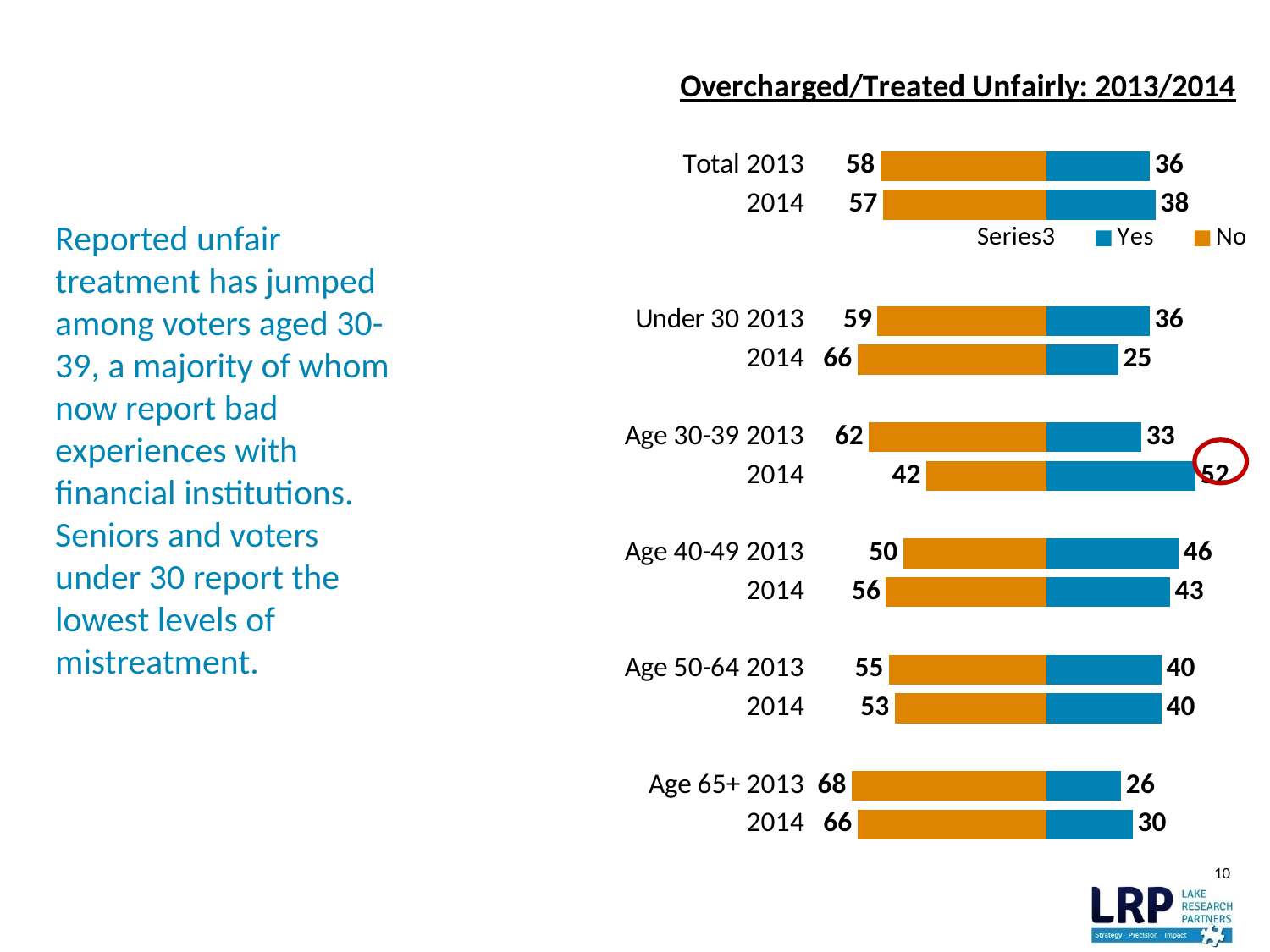
By how much did the "Yes" value for Age 30-39 change from 2013 to 2014? 19 What is the difference between the "No" and "Yes" values for Age 65+ in 2014? 36 Which colour represents the "No" series? Orange What is the "Yes" value for Age 30-39 in 2014? 52 What is the "No" value for Age 65+ in 2013? 68 What is the title of the chart? Overcharged/Treated Unfairly: 2013/2014 How many series does the legend list? 3 What is the "Yes" value for Total 2014? 38 What kind of chart is shown on the slide? Bar chart Which is larger, the "No" value for Under 30 2014 or the "No" value for Age 40-49 2014? Under 30 2014 Which group and year has the highest "Yes" value? Age 30-39 2014 Which group and year has the lowest "Yes" value? Under 30 2014